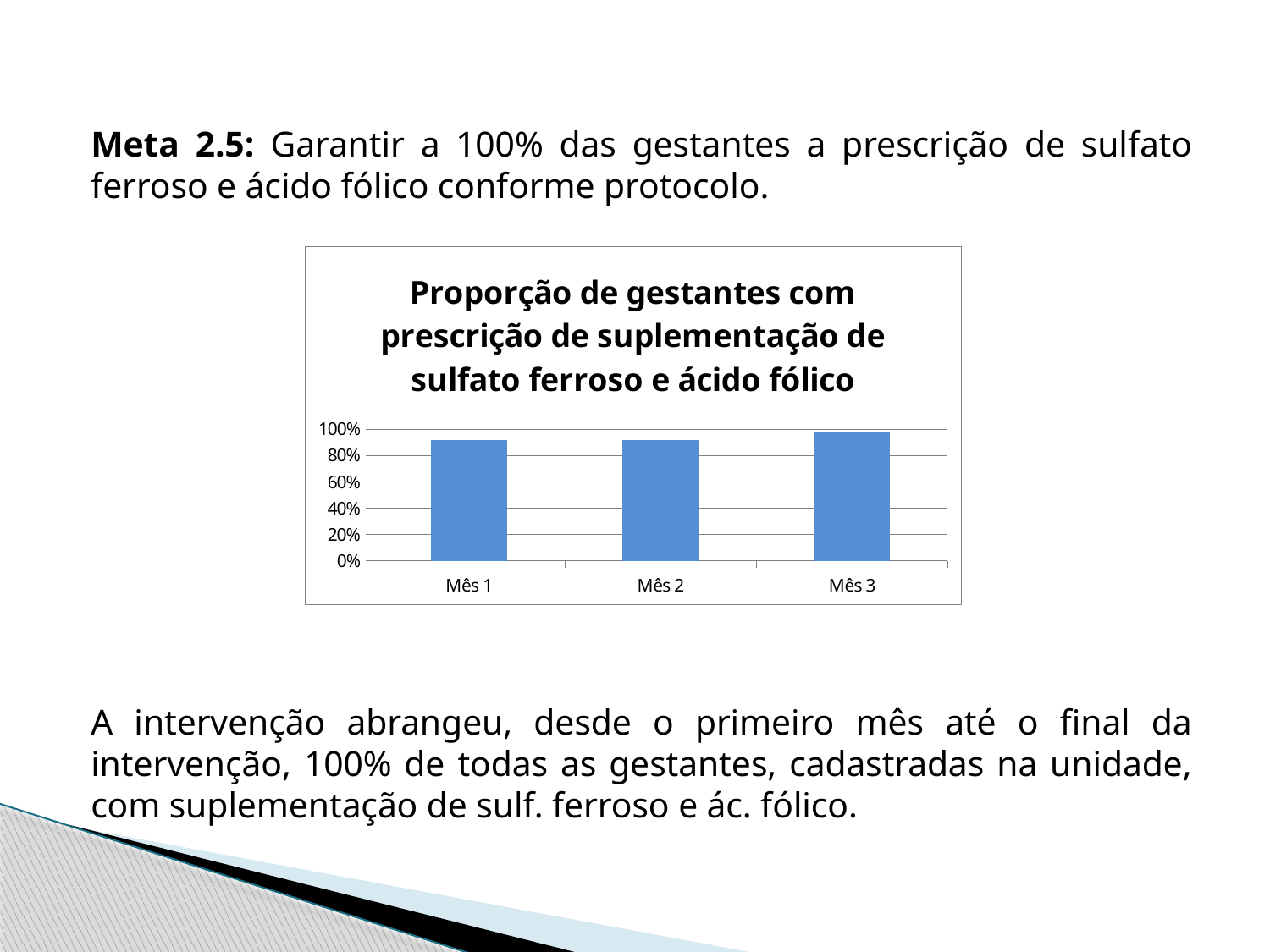
Is the value for Mês 1 greater or less than 100%? less Is the value for Mês 1 greater or less than 80%? greater Is the value for Mês 2 greater or less than 60%? greater What kind of chart is shown on the slide? bar chart What is the label of the first category on the x axis? Mês 1 What is the title of the chart? Proporção de gestantes com prescrição de suplementação de sulfato ferroso e ácido fólico What is the highest value shown on the y axis of the chart? 100% How many categories (months) are shown on the x axis of the chart? 3